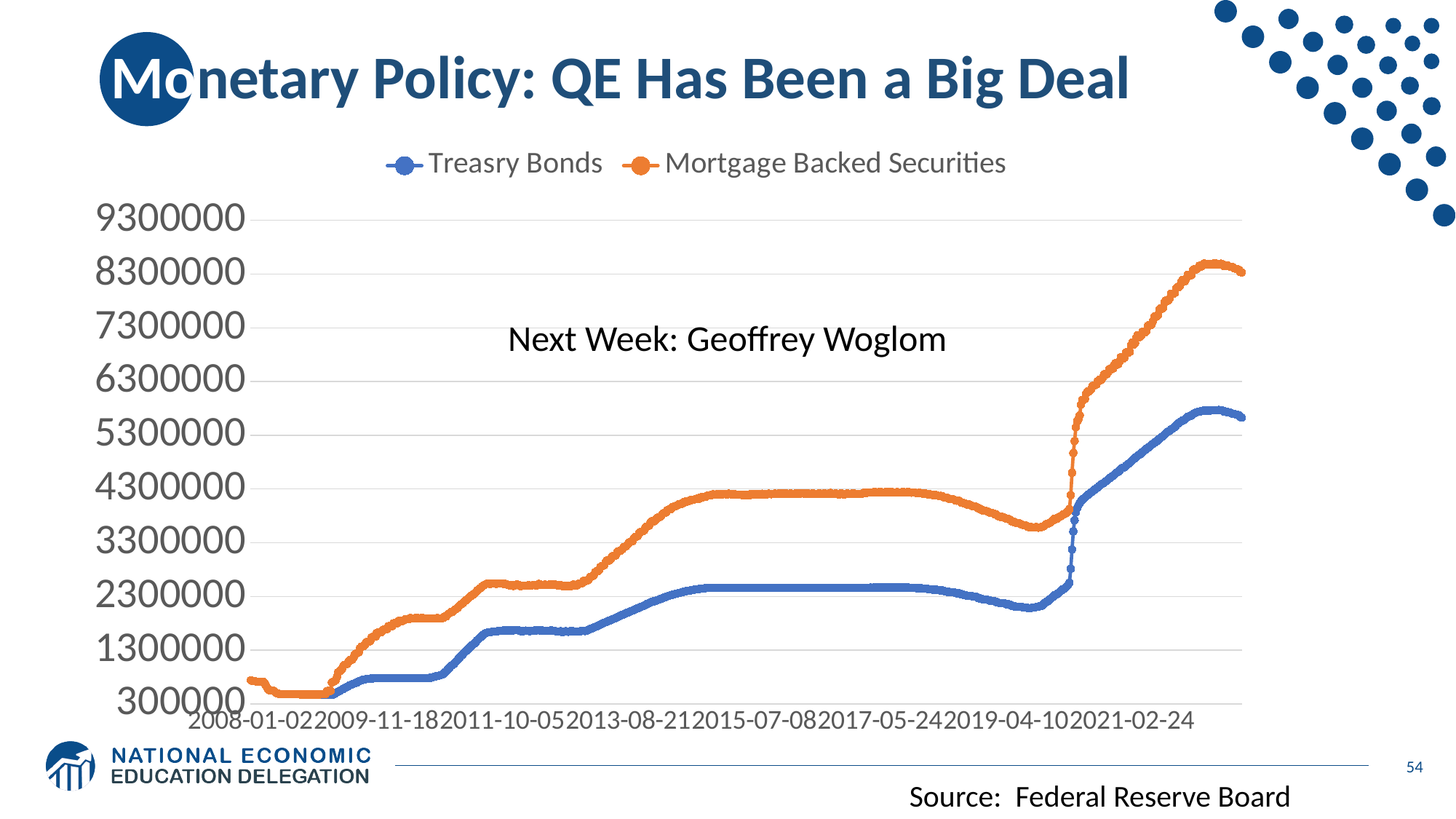
What kind of chart is shown on the slide? Line chart Which series has the higher value at the right end of the chart? Mortgage Backed Securities What are the two series named in the legend? Treasry Bonds and Mortgage Backed Securities Is the value of Treasry Bonds around 2017-05-24 greater or less than 3300000? less How many series does the legend list? 2 Overall, do the Mortgage Backed Securities values rise or fall from 2008-01-02 to the end of the chart? Rise Is the peak value of Mortgage Backed Securities greater or less than 7300000? greater Is the value of Mortgage Backed Securities around 2017-05-24 greater or less than 3300000? greater Which series is drawn in orange? Mortgage Backed Securities Overall, do the Treasry Bonds values rise or fall from the left of the x axis to the right? Rise